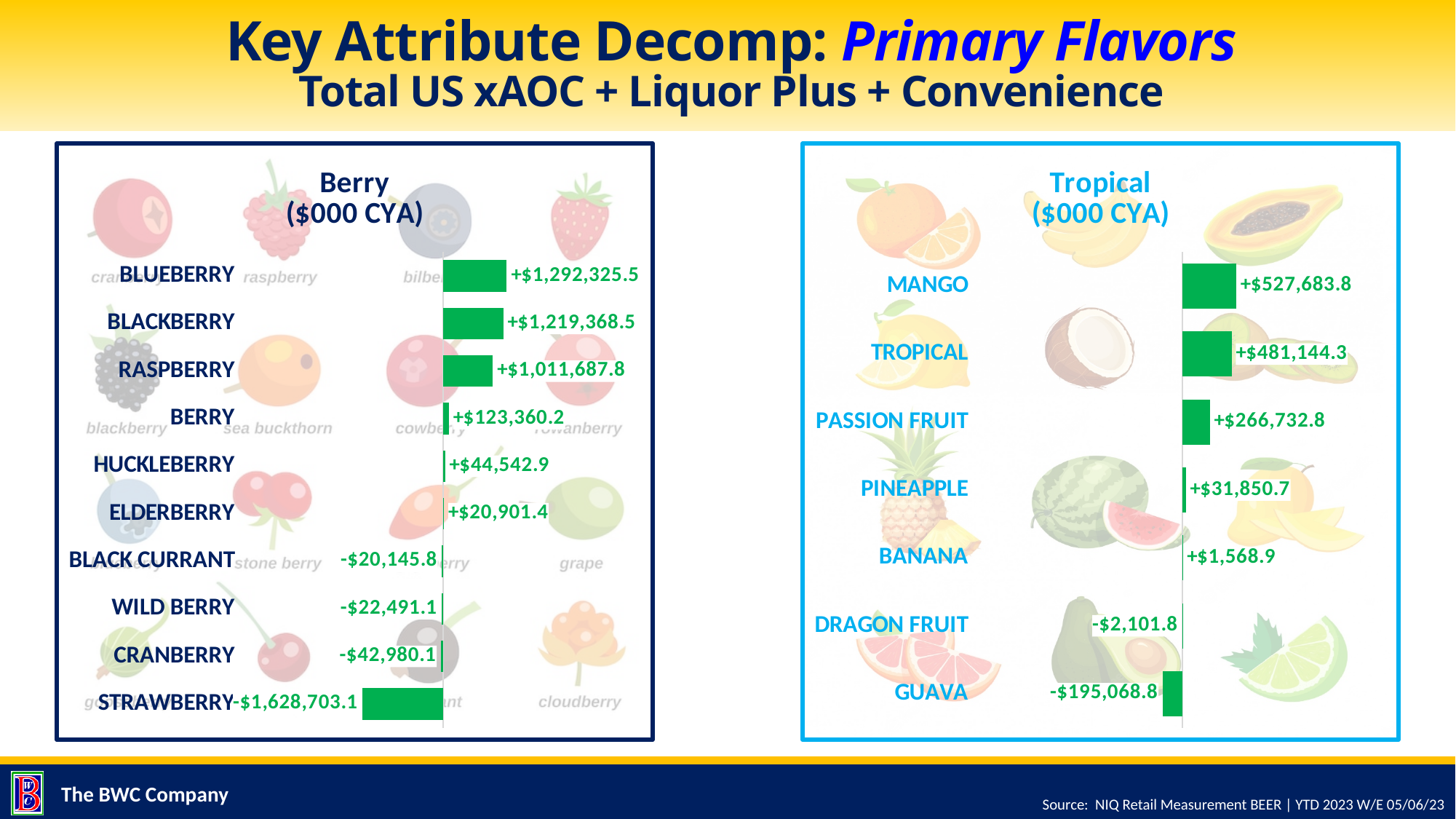
In the Berry ($000 CYA) chart, which category has the lowest value? STRAWBERRY In the Tropical ($000 CYA) chart, how many categories are shown? 7 In the Tropical ($000 CYA) chart, what is the value for GUAVA? -$195,068.8 What kind of chart is the Tropical ($000 CYA) chart? Bar chart In the Berry ($000 CYA) chart, how many categories are shown? 10 In the Berry ($000 CYA) chart, which category has the highest value? BLUEBERRY In the Berry ($000 CYA) chart, what is the difference between the BLUEBERRY and BLACKBERRY values? $72,957.0 In the Tropical ($000 CYA) chart, which category has the highest value? MANGO In the Tropical ($000 CYA) chart, what is the value for PASSION FRUIT? +$266,732.8 In the Tropical ($000 CYA) chart, which is larger, the value for PINEAPPLE or the value for BANANA? PINEAPPLE In the Berry ($000 CYA) chart, what is the value for STRAWBERRY? -$1,628,703.1 In the Berry ($000 CYA) chart, what is the value for BLUEBERRY? +$1,292,325.5